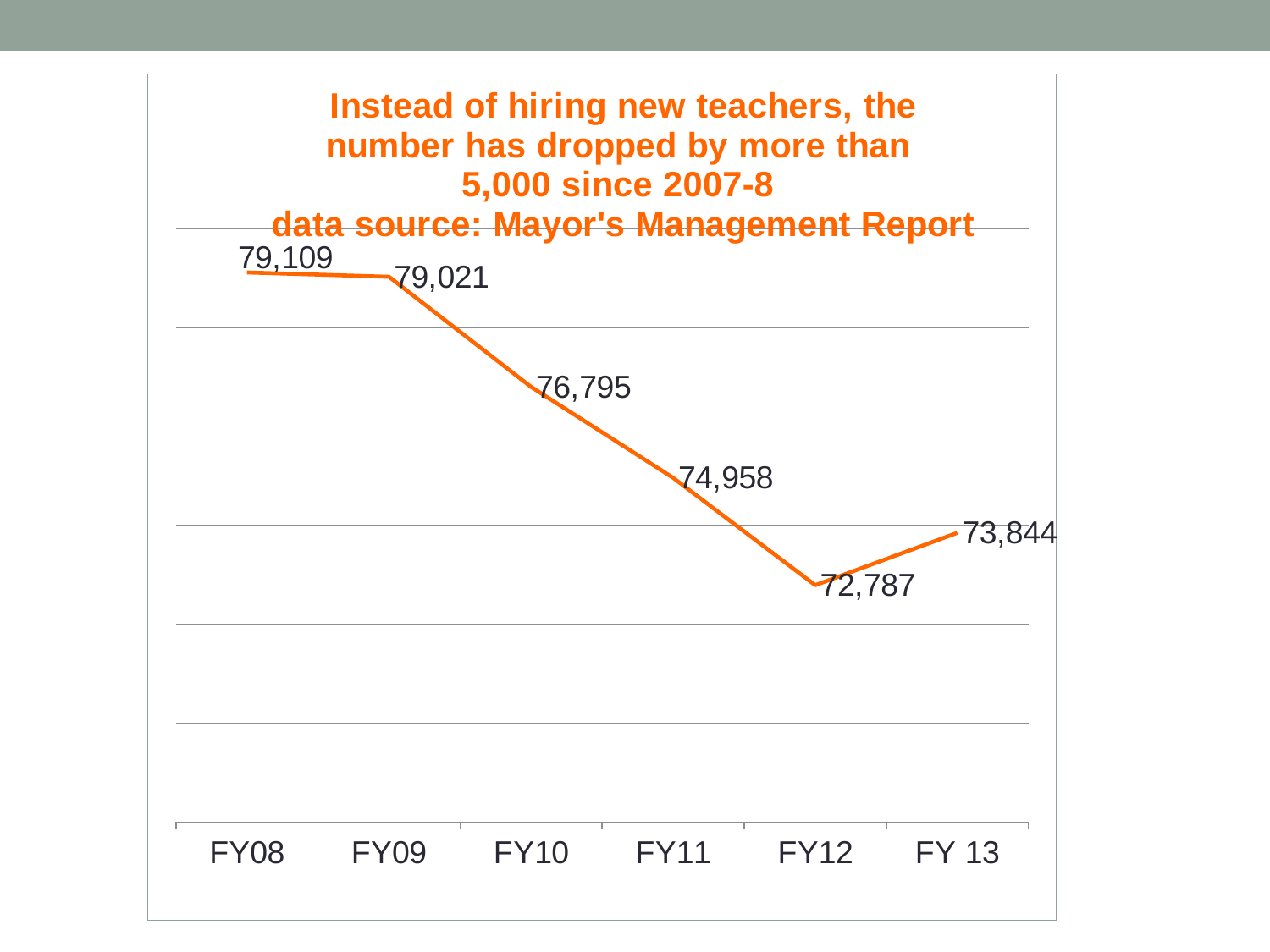
By how much did the value increase from FY12 to FY 13? 1,057 Do the values rise or fall from FY08 to FY12? Fall What data source is named in the chart title? Mayor's Management Report What is the value for FY 13? 73,844 What kind of chart is shown on the slide? Line chart Which is larger, the value for FY10 or the value for FY11? FY10 Which fiscal year has the highest value? FY08 How many fiscal years are plotted on the x axis? 6 What is the difference between the FY08 value and the FY12 value? 6,322 What is the value for FY08? 79,109 What is the value for FY10? 76,795 Which fiscal year has the lowest value? FY12